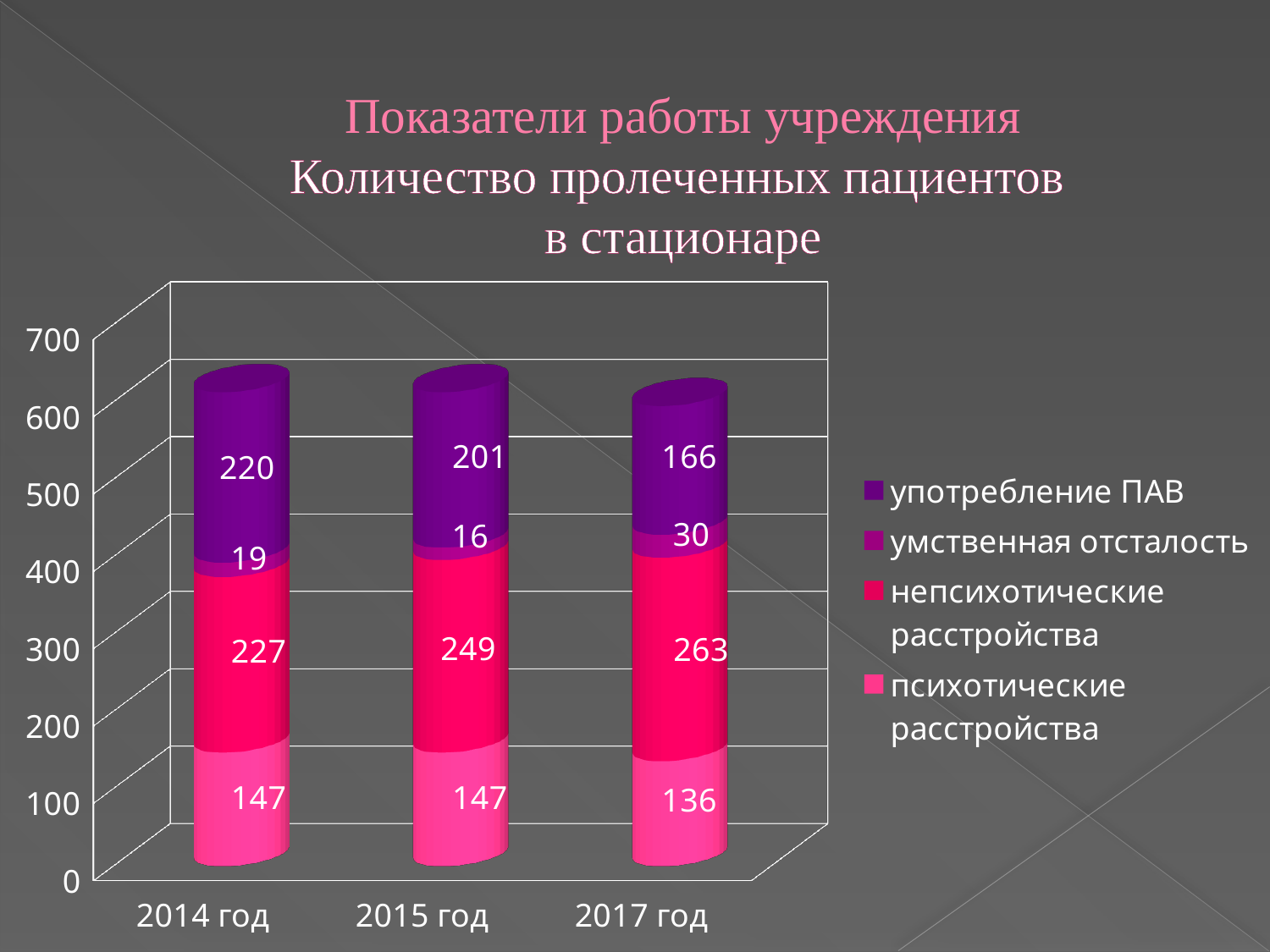
What is the difference between the values for употребление ПАВ in 2014 год and 2017 год? 54 In which year is the value for употребление ПАВ the lowest? 2017 год What is the value for употребление ПАВ in 2014 год? 220 How many series does the legend list? 4 What is the value for непсихотические расстройства in 2017 год? 263 What is the total of the stacked bar for 2014 год? 613 In which year is the value for непсихотические расстройства the highest? 2017 год What is the value for психотические расстройства in 2017 год? 136 What is the value for умственная отсталость in 2015 год? 16 What kind of chart is shown on the slide? Stacked bar chart Which is larger: умственная отсталость in 2017 год or in 2014 год? 2017 год How many years are shown on the x axis? 3